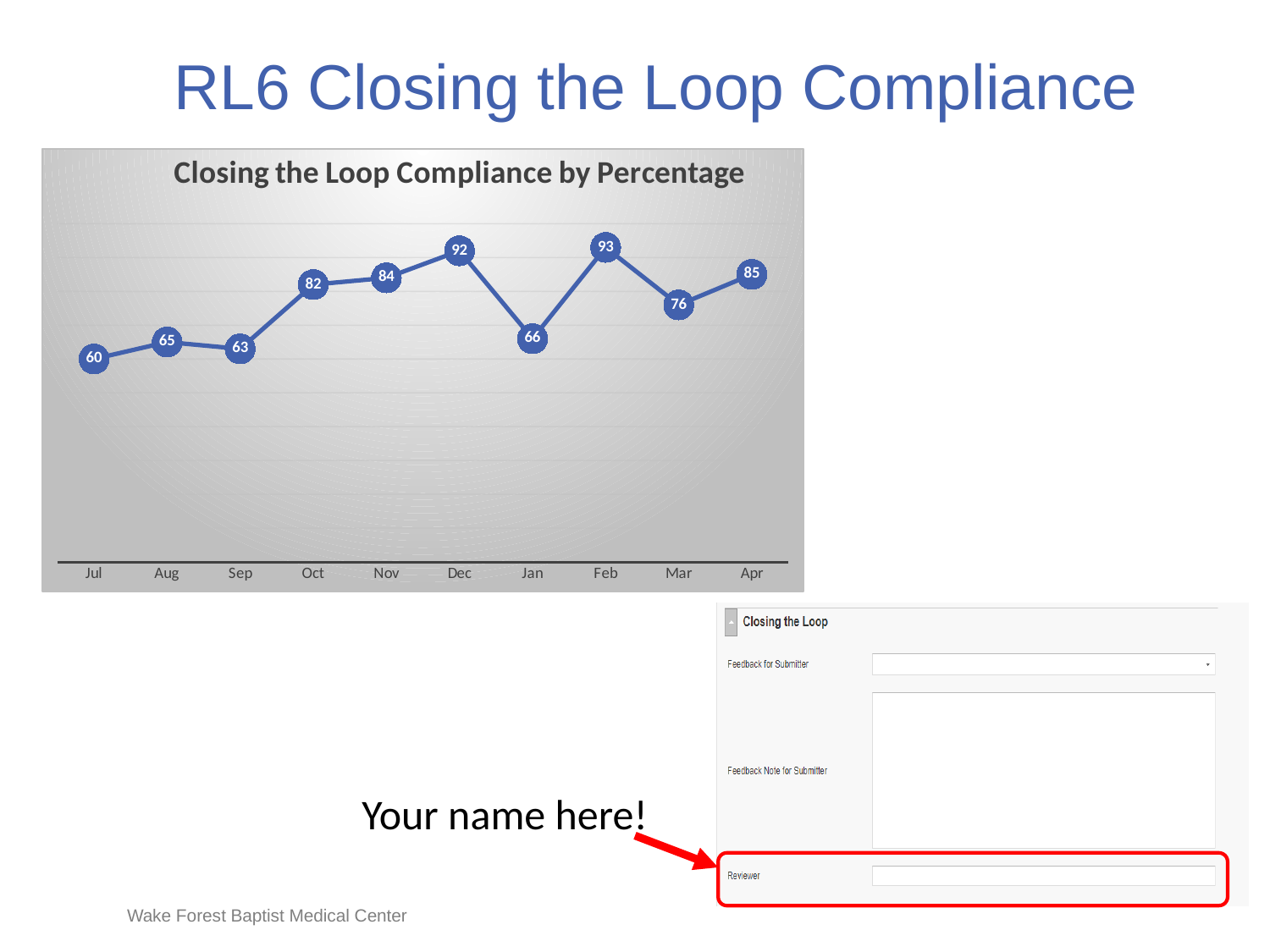
What is the difference between the values for Apr and Mar? 9 What is the value for Dec? 92 What is the value for Jul? 60 How many months are plotted on the chart? 10 Do the values rise or fall from Dec to Jan? Fall What is the value for Mar? 76 What kind of chart is shown? Line chart What is the difference between the values for Feb and Jan? 27 Which month has the highest value? Feb What is the title of the chart? Closing the Loop Compliance by Percentage Which is larger, the value for Oct or the value for Nov? Nov Which month has the lowest value? Jul